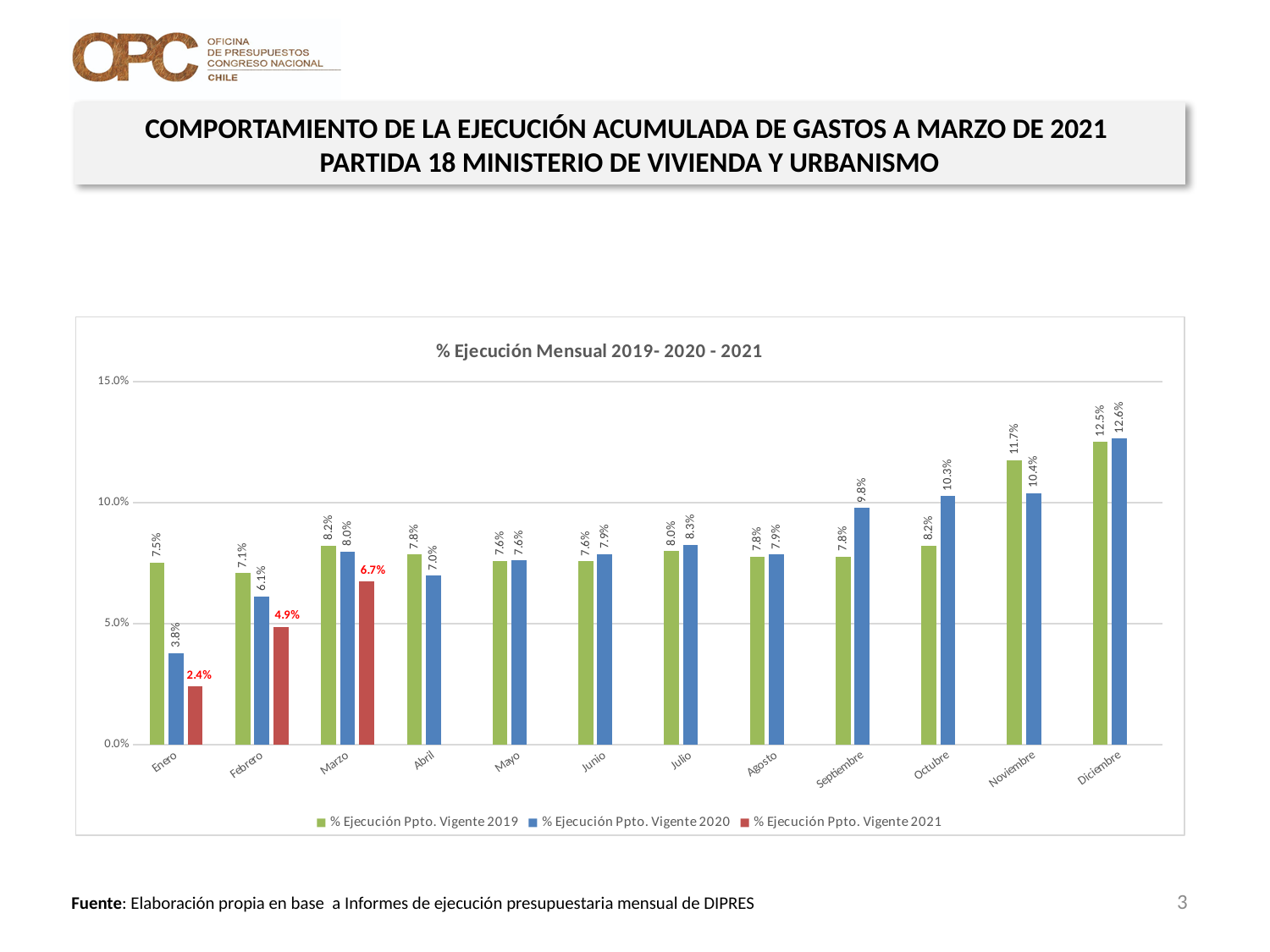
What is the title of the chart? % Ejecución Mensual 2019- 2020 - 2021 What kind of chart is shown? Bar chart What is the difference between the 2019 and 2021 values in Enero? 5.1% What is the value for % Ejecución Ppto. Vigente 2020 in Enero? 3.8% Is the value for % Ejecución Ppto. Vigente 2020 in Octubre greater or less than 10.0%? greater Which month has the lowest value for % Ejecución Ppto. Vigente 2019? Febrero In Septiembre, which is larger: the 2019 value or the 2020 value? 2020 Which month has the highest value for % Ejecución Ppto. Vigente 2020? Diciembre How many months are shown on the x axis? 12 How many series does the legend list? 3 What is the value for % Ejecución Ppto. Vigente 2021 in Marzo? 6.7% What is the value for % Ejecución Ppto. Vigente 2019 in Noviembre? 11.7%